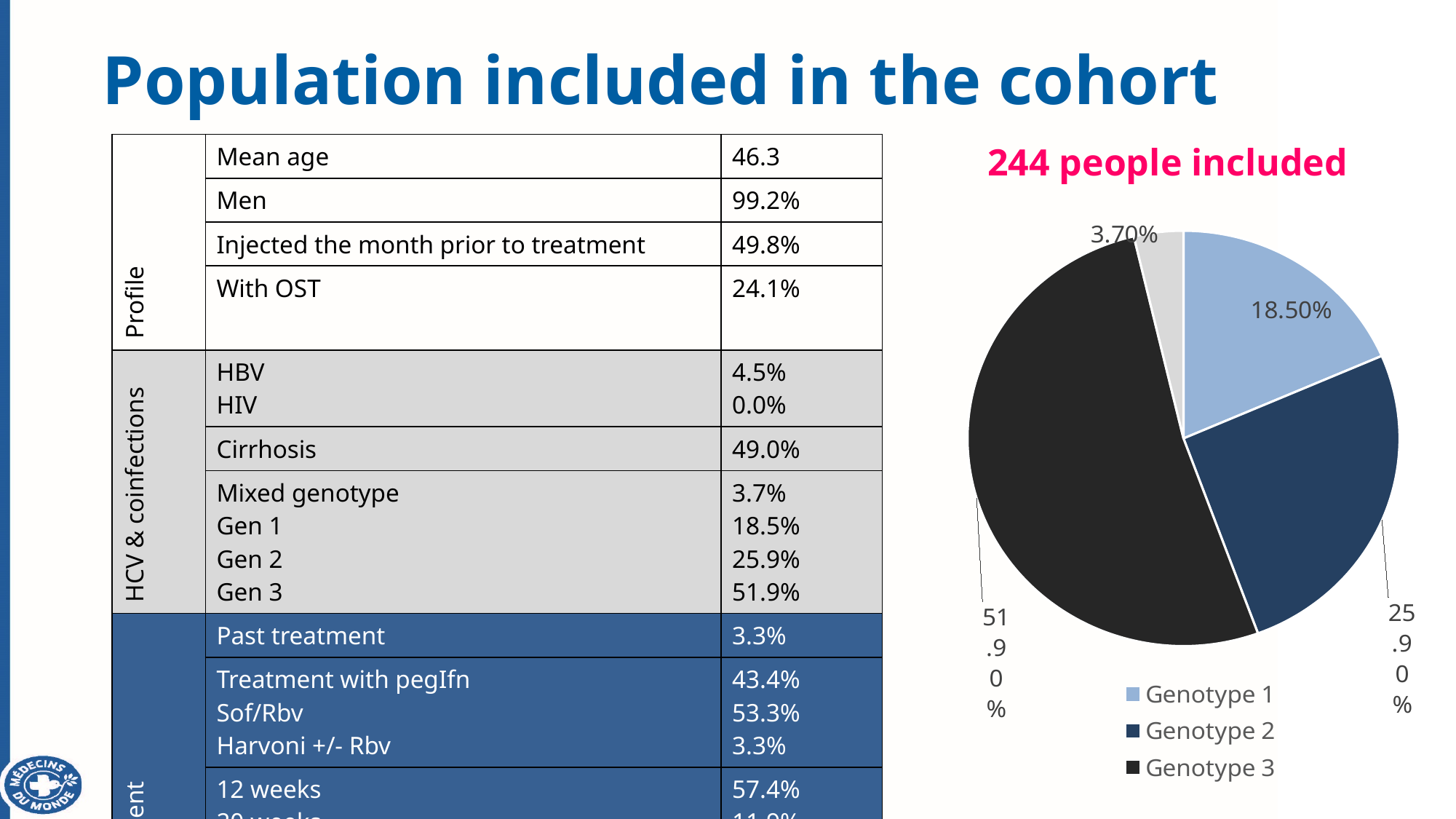
What share of the pie chart is Genotype 3? 51.90% By how many percentage points does the Genotype 3 slice exceed the Genotype 2 slice? 26.00% What is the data label on the smallest slice of the pie chart? 3.70% What colour is the Genotype 3 slice in the pie chart? black Of the three genotypes listed in the legend, which has the smallest slice? Genotype 1 What share of the pie chart is Genotype 1? 18.50% Which slice is larger in the pie chart, Genotype 1 or Genotype 2? Genotype 2 How many entries does the pie chart legend list? 3 What kind of chart is shown on the right of the slide? pie chart How many slices does the pie chart have? 4 What share of the pie chart is Genotype 2? 25.90% Which genotype has the largest slice in the pie chart? Genotype 3